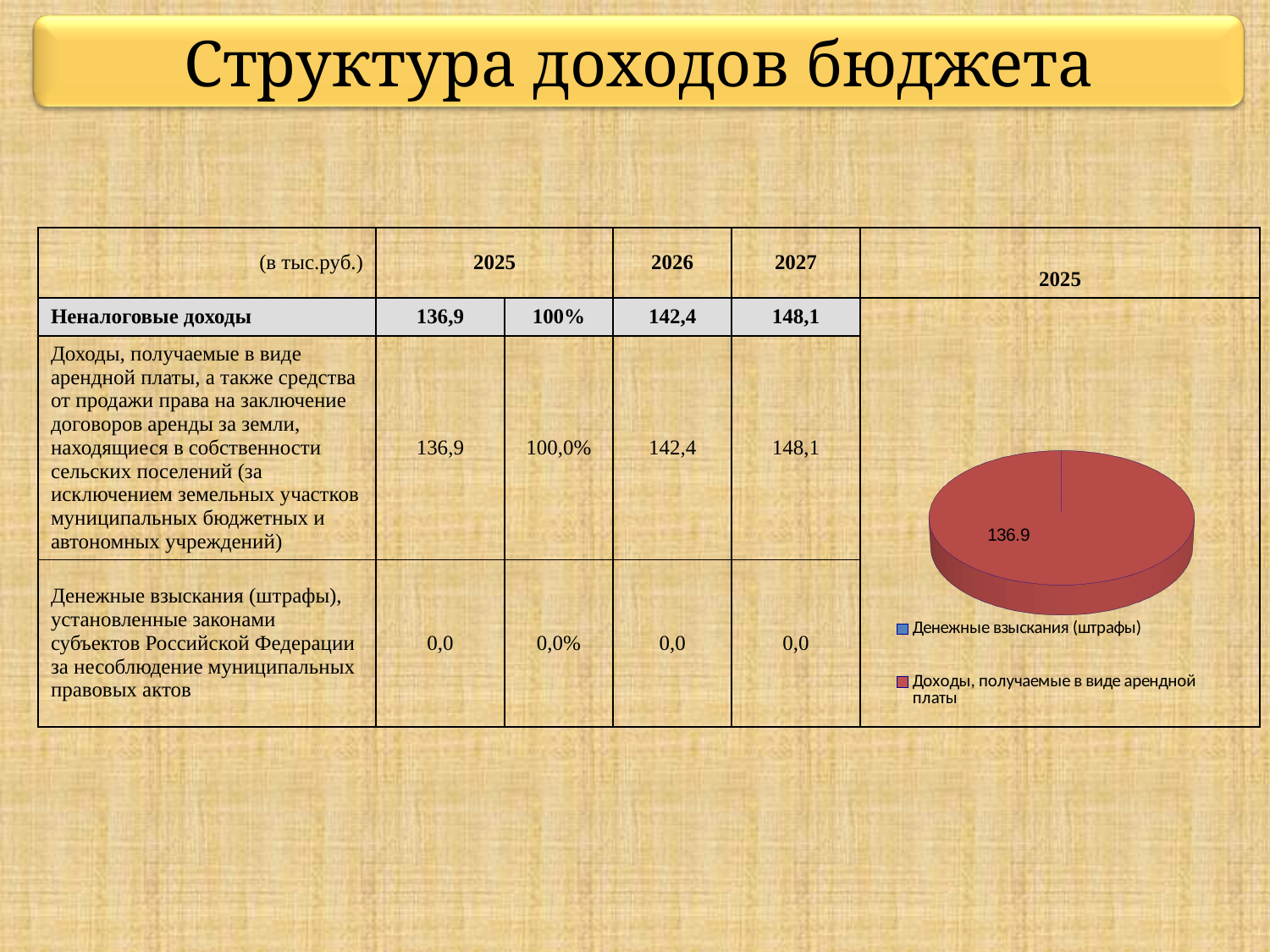
What kind of chart is shown on the slide? pie chart What is the title of the pie chart? 2025 Which legend category does the visible slice of the pie chart represent? Доходы, получаемые в виде арендной платы Which category in the pie chart has the larger value, Денежные взыскания (штрафы) or Доходы, получаемые в виде арендной платы? Доходы, получаемые в виде арендной платы What colour is the slice for Доходы, получаемые в виде арендной платы in the pie chart? red Is the value shown on the pie chart's slice greater or less than 100? greater How many slices are visible in the pie chart? 1 What value is printed on the pie chart's slice? 136.9 How many entries does the legend of the pie chart list? 2